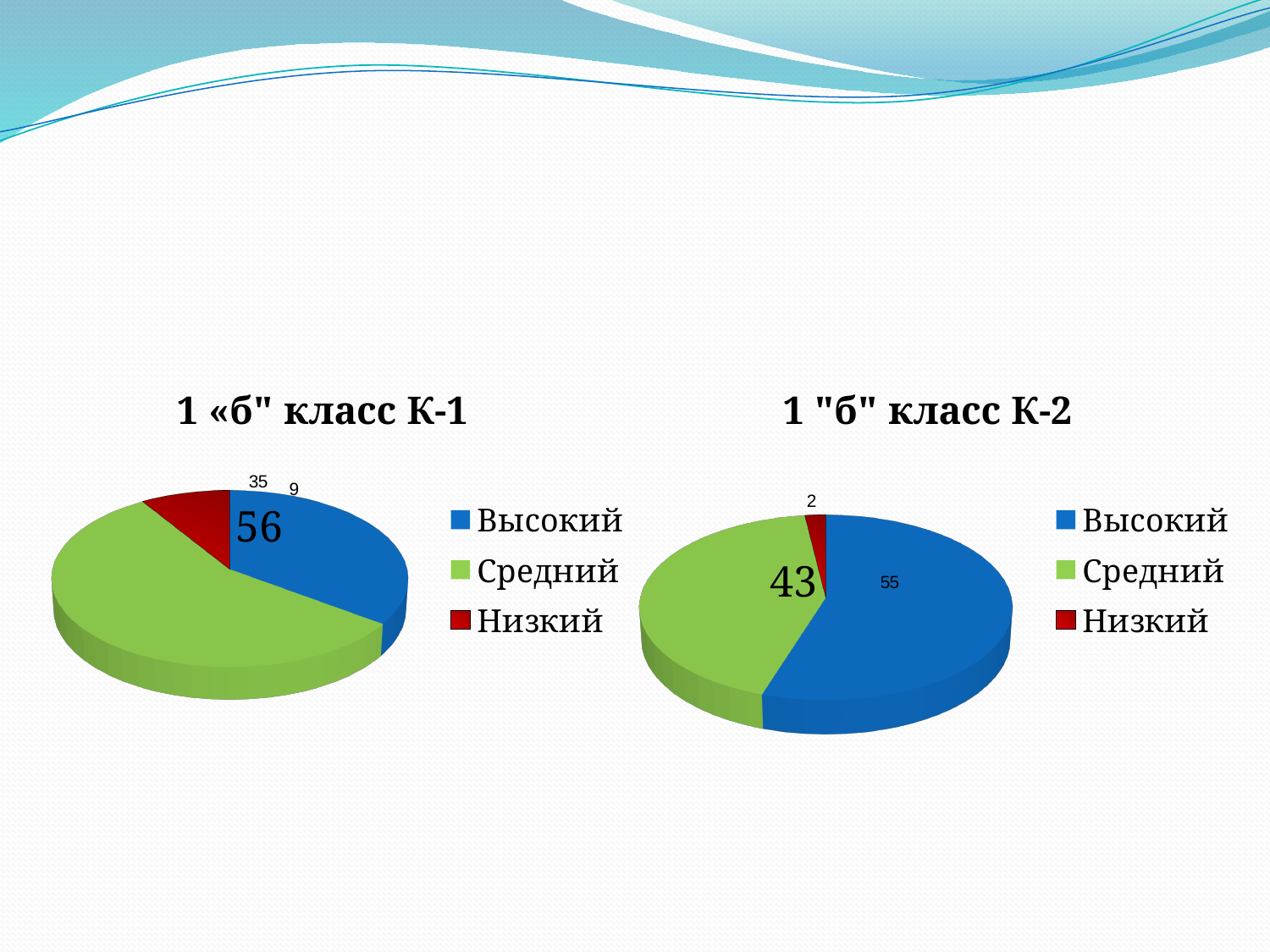
In the chart titled 1 "б" класс К-2, which is larger: Средний or Низкий? Средний In the chart titled 1 «б" класс К-1, which category has the smallest slice? Низкий In the chart titled 1 "б" класс К-2, which category has the smallest slice? Низкий How many entries does the legend of the chart titled 1 «б" класс К-1 list? 3 In the chart titled 1 "б" класс К-2, what is the value for Средний? 43 In the chart titled 1 "б" класс К-2, which category has the largest slice? Высокий In the chart titled 1 "б" класс К-2, what is the value for Высокий? 55 In the chart titled 1 "б" класс К-2, what is the difference between the values for Высокий and Средний? 12 In the chart titled 1 "б" класс К-2, what is the value for Низкий? 2 In the chart titled 1 «б" класс К-1, which category has the largest slice? Средний In the chart titled 1 «б" класс К-1, which is larger: Средний or Высокий? Средний What type of chart is the chart titled 1 "б" класс К-2? Pie chart